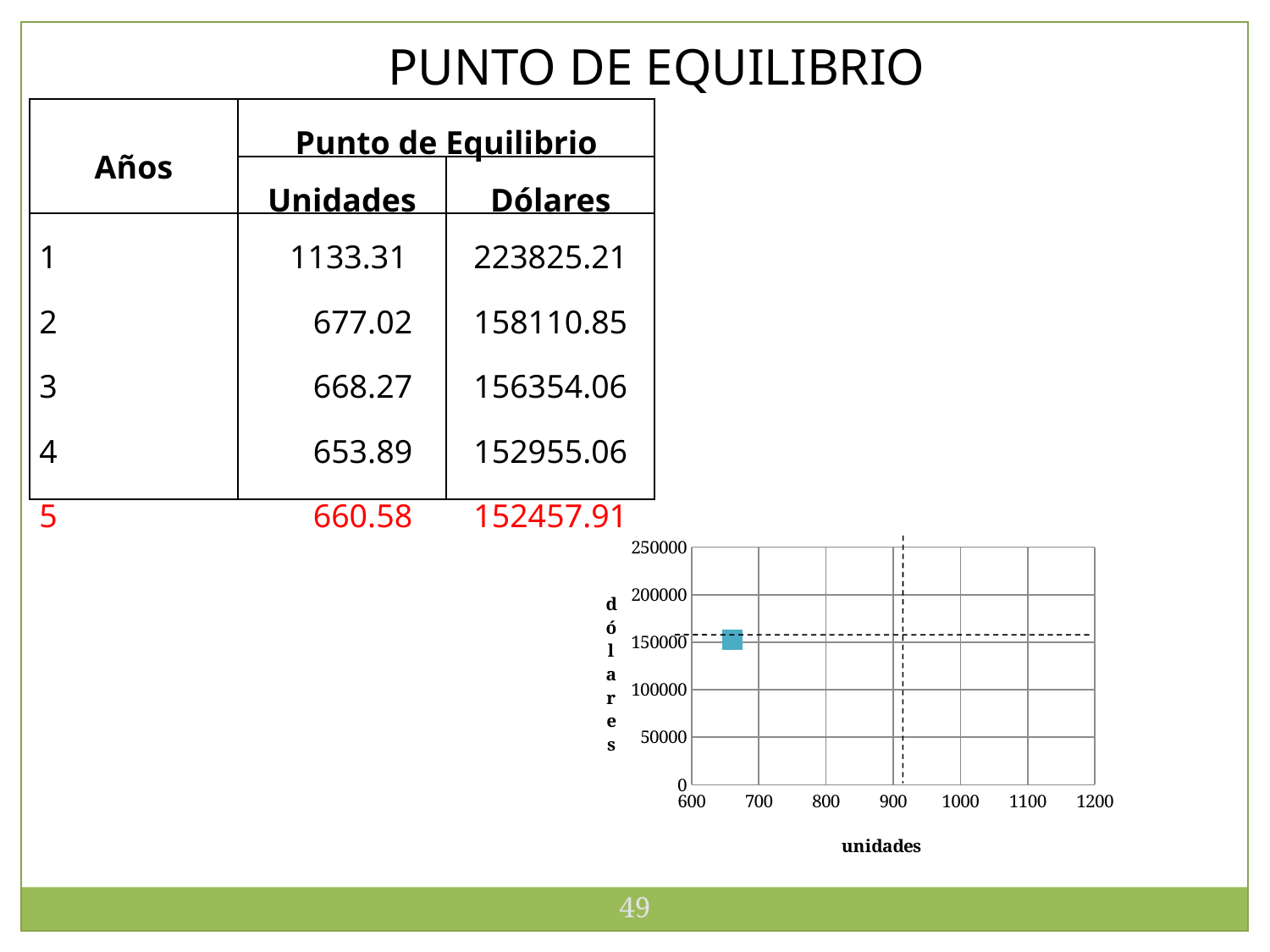
What is the label of the chart's y axis? dólares Is the unidades (x-axis) value of the plotted point greater or less than 900? less Is the unidades (x-axis) value of the plotted point greater or less than 700? less Is the dólares (y-axis) value of the plotted point greater or less than 200000? less How many data points are plotted on the chart? 1 What kind of chart is shown on the slide? scatter chart What is the label of the chart's x axis? unidades